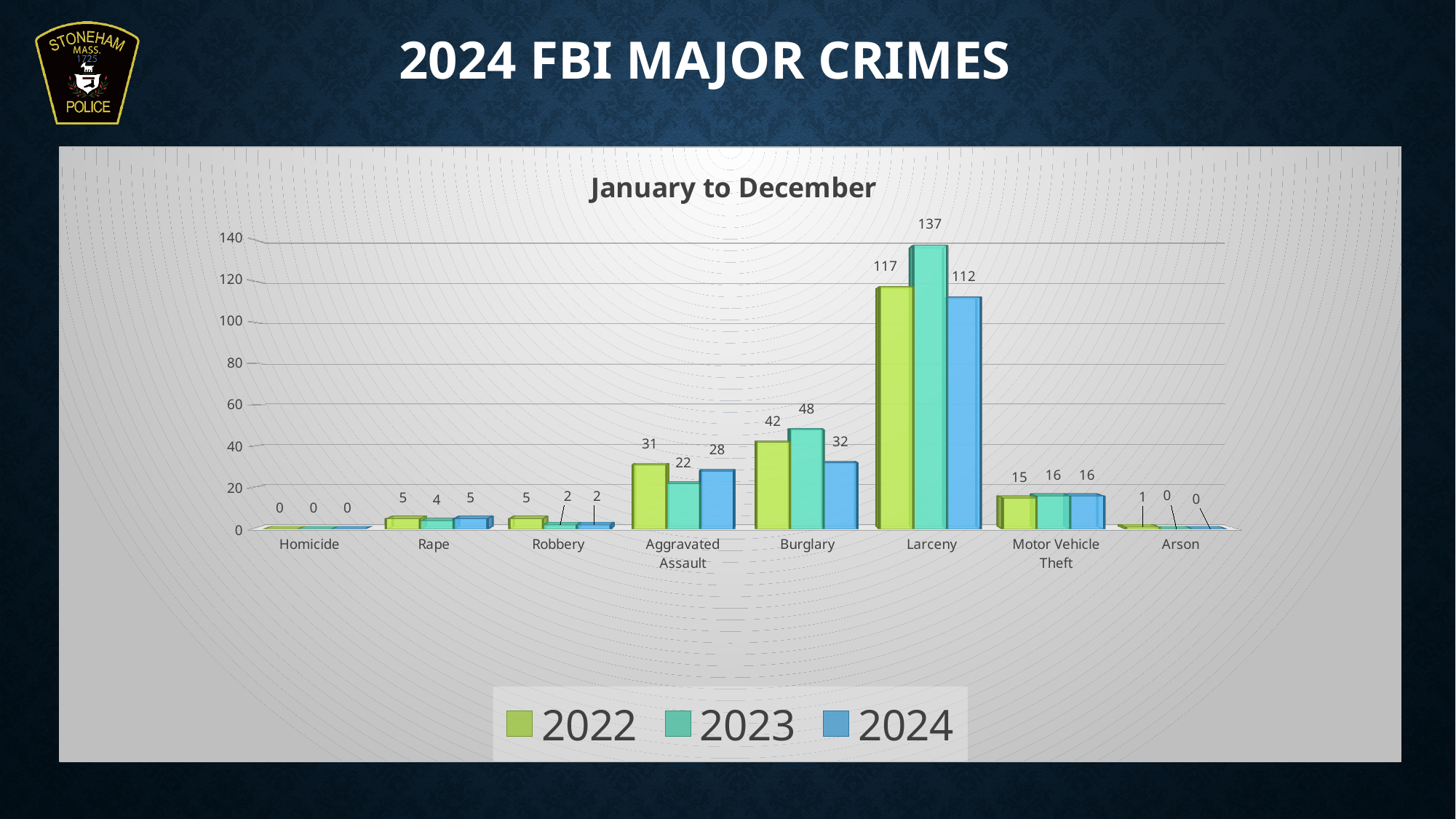
Which is larger for Burglary: the 2022 value or the 2023 value? 2023 Is the value for Larceny in 2022 greater or less than 100? greater Which category has the highest value in the 2024 series? Larceny Which category has the lowest value in the 2022 series? Homicide What is the difference between the 2023 and 2024 values for Larceny? 25 What is the value for Larceny in 2023? 137 How many series does the legend list? 3 How many crime categories are shown on the x axis? 8 What is the value for Burglary in 2024? 32 What is the title shown above the chart's plot area? January to December What is the value for Aggravated Assault in 2022? 31 What kind of chart is shown on the slide? Bar chart